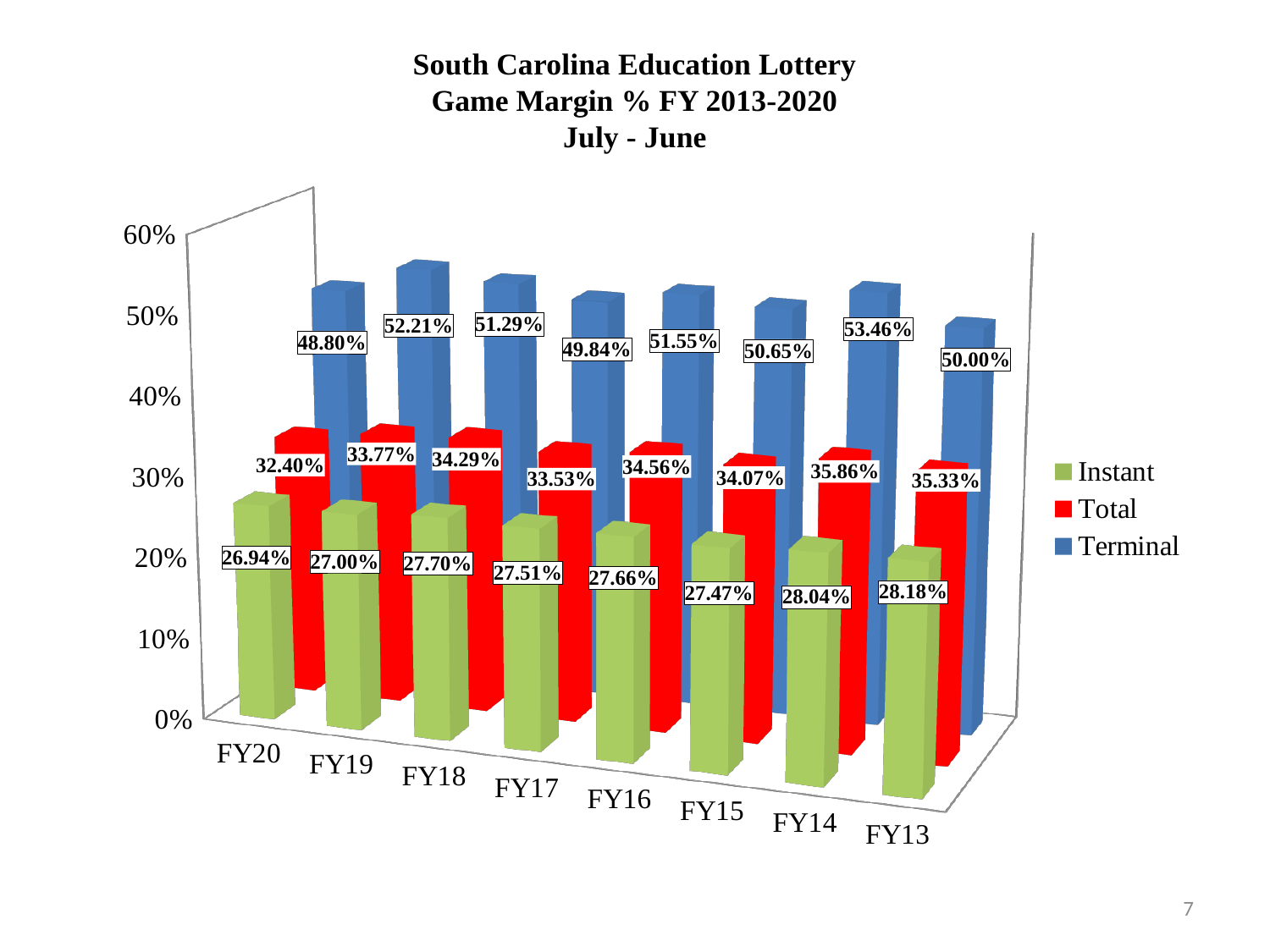
Which fiscal year has the lowest Total margin? FY20 Which colour represents the Terminal series in the legend? Blue Which fiscal year has the lowest Instant margin? FY20 What kind of chart is shown on the slide? Bar chart What is the Terminal game margin for FY19? 52.21% How many series does the legend list? 3 What is the Total game margin for FY16? 34.56% Which is larger, the Total margin for FY13 or for FY14? FY14 What is the difference between the Terminal margin in FY14 and in FY20? 4.66 percentage points What is the Instant game margin for FY13? 28.18% Which fiscal year has the highest Terminal margin? FY14 How many fiscal years are shown on the x axis? 8